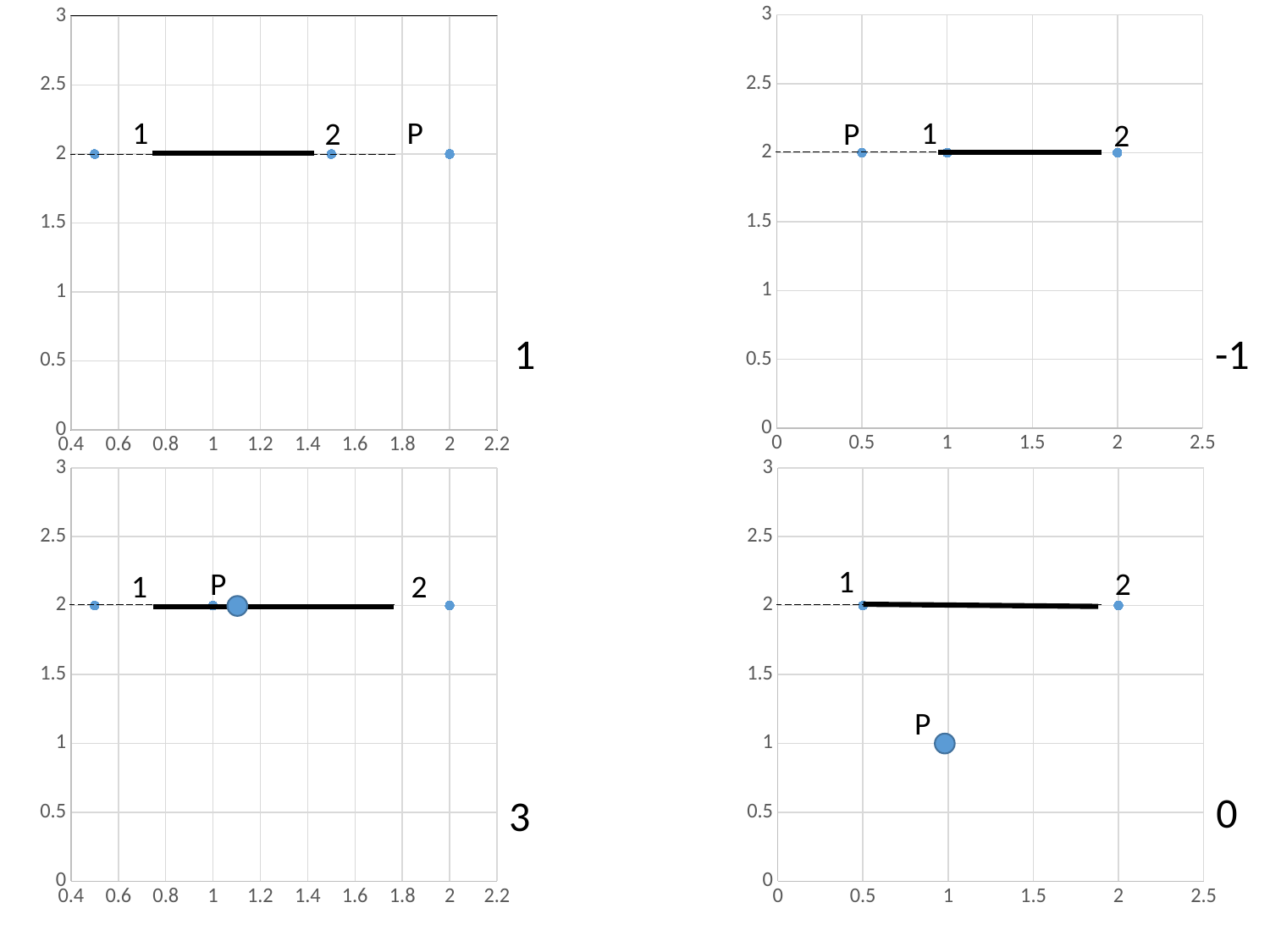
What kind of chart is the top-left chart? scatter chart In the top-right chart, what is the x value of the point labelled P? 0.5 In the bottom-right chart, what is the y value of the large point labelled P? 1 How many charts are shown on the slide? 4 What number is printed in the lower-right corner of the bottom-left chart? 3 In the bottom-right chart, is the y value of point P greater or less than the y value of point 2? less In the bottom-right chart, what is the x value of the large point labelled P? 1 What is the maximum value shown on the y axis of the top-left chart? 3 What number is printed in the lower-right corner of the top-right chart? -1 In the top-right chart, what is the y value of the point labelled P? 2 In the bottom-right chart, is the y value of point P greater or less than 1.5? less In the bottom-left chart, what is the y value of the large point labelled P? 2